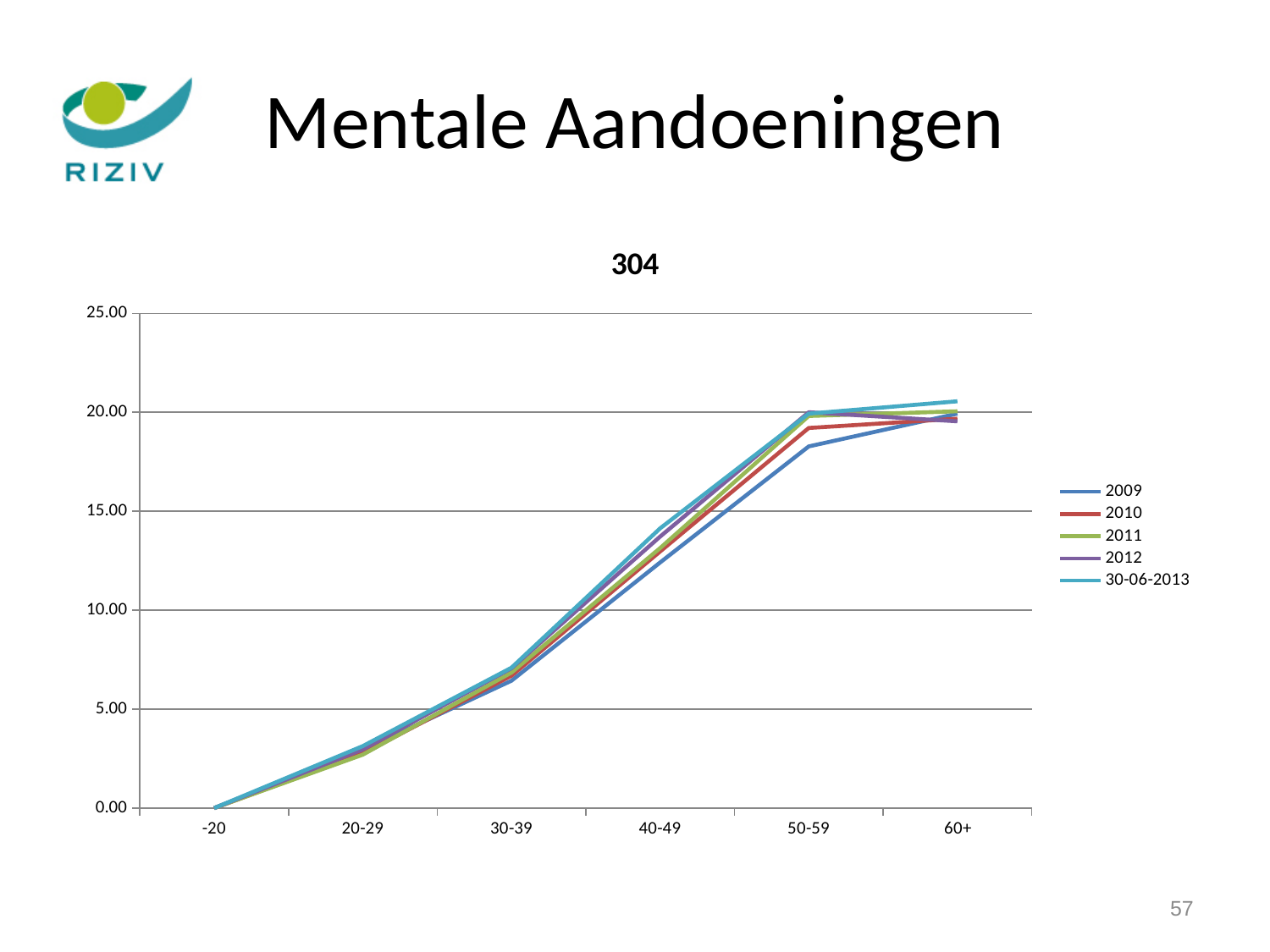
What kind of chart is shown on the slide? line chart How many age categories are shown on the x axis? 6 What is the value for the 2009 series at the -20 category? 0.00 Is the value for 30-06-2013 at 60+ greater or less than 20.00? greater Do the values for the 2009 series rise or fall from -20 to 60+? rise Is the value for 2009 at 40-49 greater or less than 15.00? less Which age category has the lowest value for the 2010 series? -20 Is the value for 2009 at 50-59 greater or less than 20.00? less What is the title of the chart? 304 At 50-59, which series has the larger value: 2009 or 30-06-2013? 30-06-2013 What is the last entry in the legend? 30-06-2013 How many series does the legend list? 5